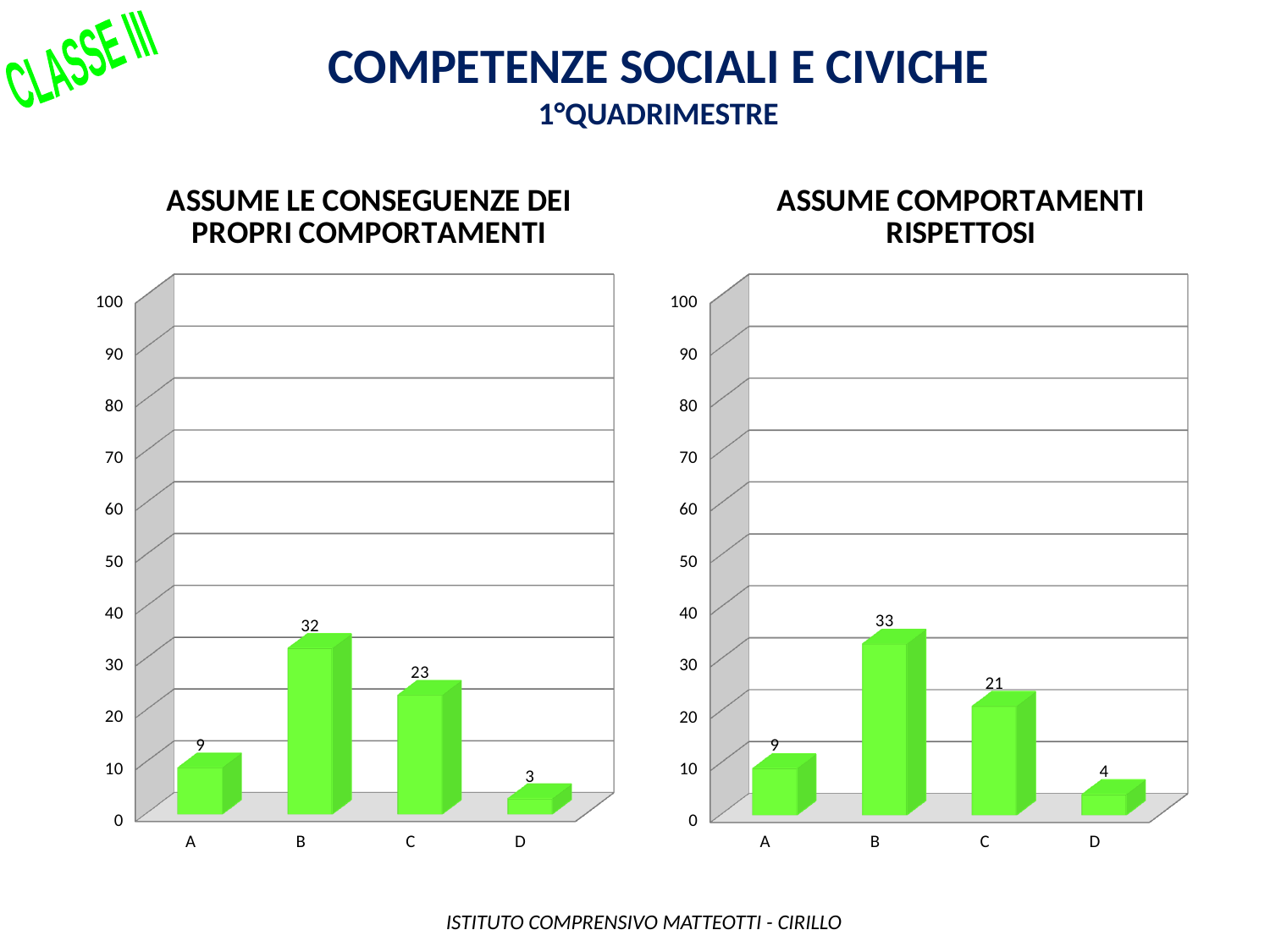
In the right chart 'ASSUME COMPORTAMENTI RISPETTOSI', which category has the lowest value? D What kind of chart is the left chart 'ASSUME LE CONSEGUENZE DEI PROPRI COMPORTAMENTI'? bar chart In the right chart 'ASSUME COMPORTAMENTI RISPETTOSI', what is the difference between the values for B and A? 24 In the left chart 'ASSUME LE CONSEGUENZE DEI PROPRI COMPORTAMENTI', which category has the highest value? B How many categories are shown on the x axis of the right chart 'ASSUME COMPORTAMENTI RISPETTOSI'? 4 In the left chart 'ASSUME LE CONSEGUENZE DEI PROPRI COMPORTAMENTI', what is the difference between the values for B and C? 9 In the left chart 'ASSUME LE CONSEGUENZE DEI PROPRI COMPORTAMENTI', is the value for B greater or less than 40? less What is the title of the right chart on the slide? ASSUME COMPORTAMENTI RISPETTOSI In the right chart 'ASSUME COMPORTAMENTI RISPETTOSI', what is the value for category C? 21 In the left chart 'ASSUME LE CONSEGUENZE DEI PROPRI COMPORTAMENTI', what is the value for category B? 32 In the left chart 'ASSUME LE CONSEGUENZE DEI PROPRI COMPORTAMENTI', what is the value for category D? 3 In the right chart 'ASSUME COMPORTAMENTI RISPETTOSI', which is larger, the value for A or the value for C? C